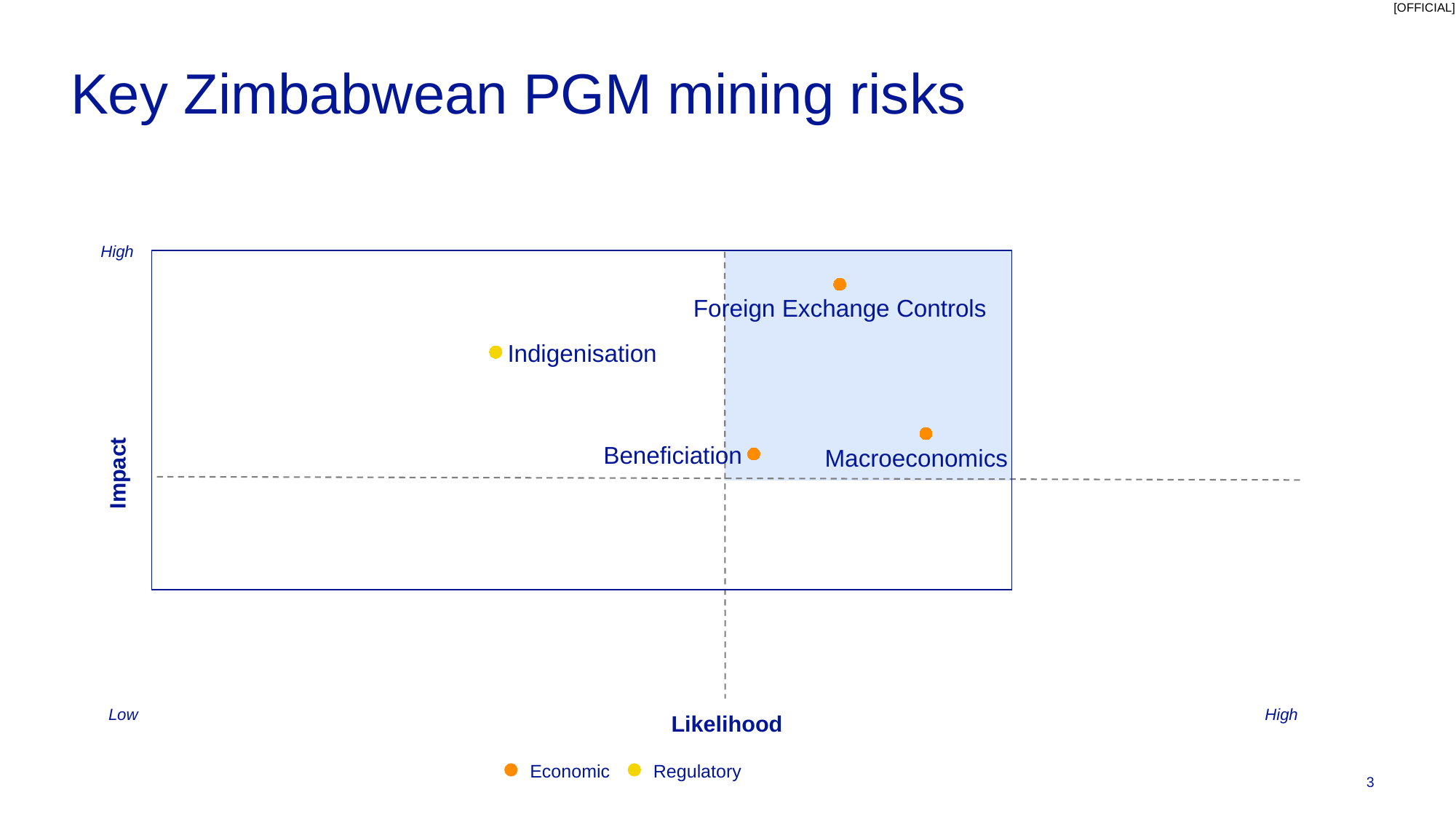
How many risks are plotted on the chart? 4 What is the label of the vertical axis? Impact Which risk has the highest likelihood? Macroeconomics Which has the higher impact, Indigenisation or Macroeconomics? Indigenisation Which risk has the highest impact? Foreign Exchange Controls Which has the higher impact, Foreign Exchange Controls or Indigenisation? Foreign Exchange Controls What kind of chart is shown on the slide? Scatter chart How many series does the legend list? 2 Which has the higher likelihood, Indigenisation or Beneficiation? Beneficiation Which risk has the lowest likelihood? Indigenisation Which risk is classified as Regulatory? Indigenisation